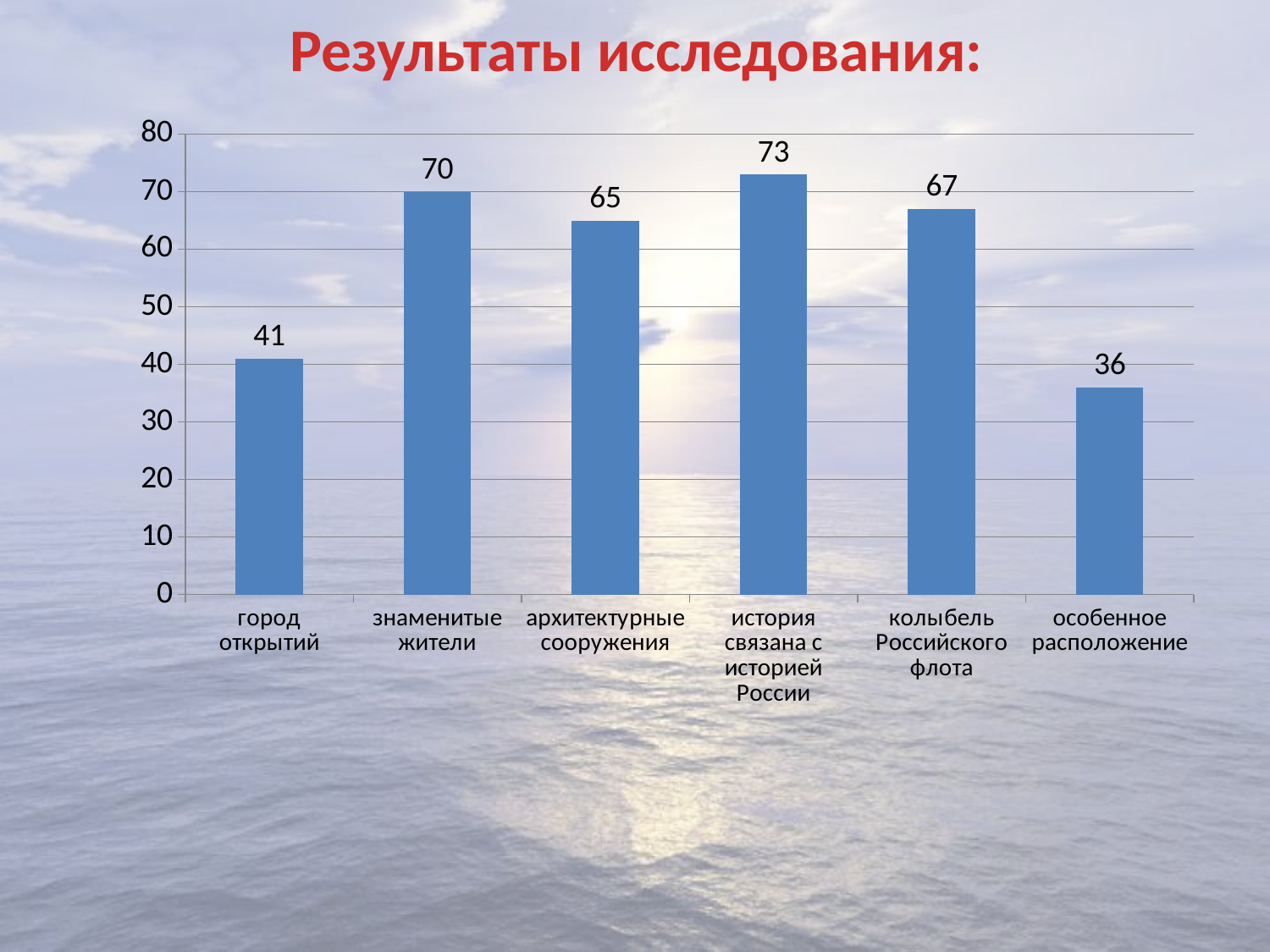
What is the value for "город открытий"? 41 What kind of chart is shown on the slide? bar chart What is the value for "знаменитые жители"? 70 Is the value for "архитектурные сооружения" greater or less than 60? greater Which category has the highest value? история связана с историей России What is the value for "особенное расположение"? 36 What is the difference between the values for "знаменитые жители" and "город открытий"? 29 What is the difference between the values for "история связана с историей России" and "колыбель Российского флота"? 6 What is the title of the slide? Результаты исследования: Which category has the lowest value? особенное расположение Which is larger, the value for "архитектурные сооружения" or the value for "колыбель Российского флота"? колыбель Российского флота How many categories are shown on the chart? 6